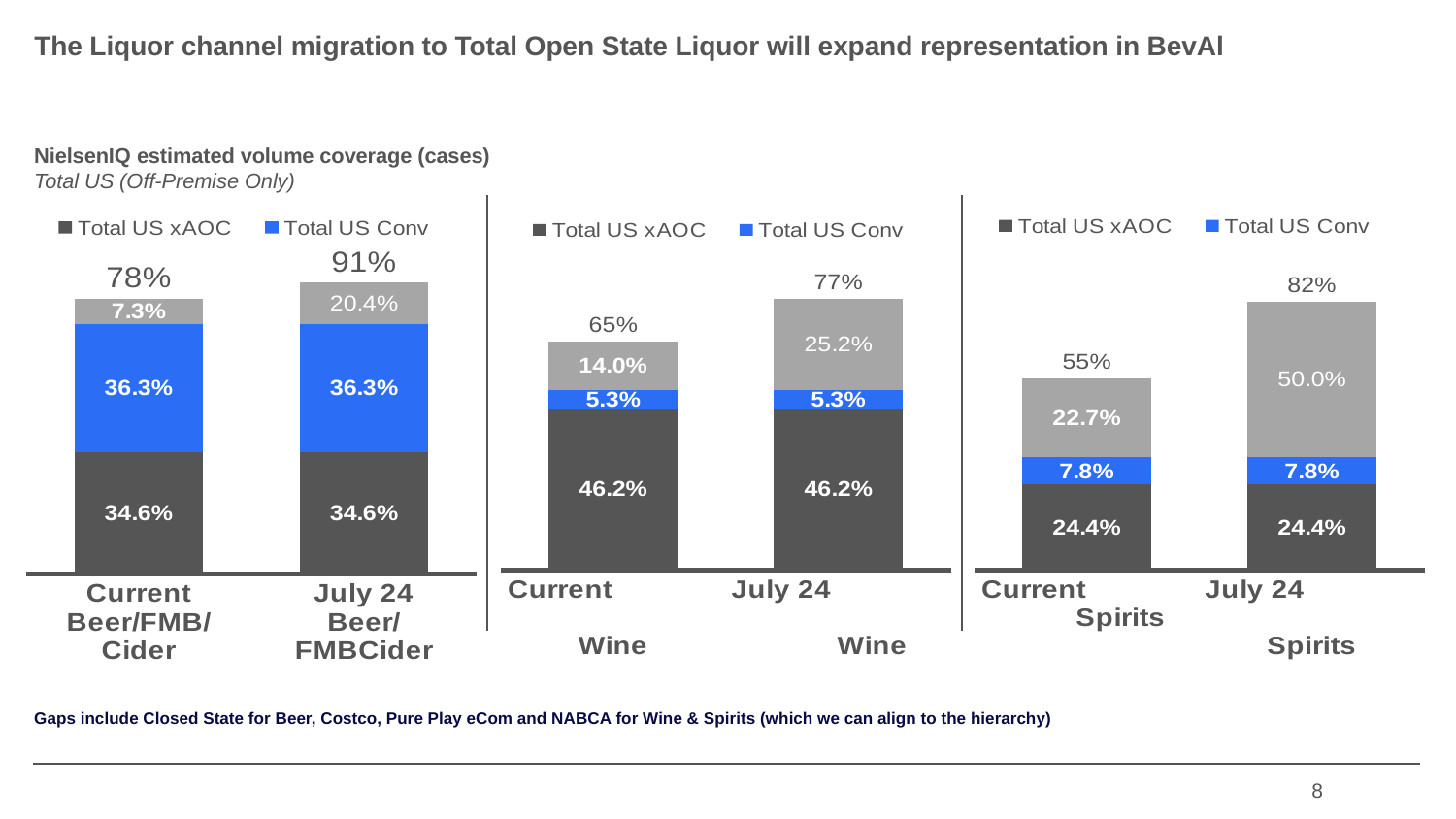
In the middle chart (Wine), what total is printed above the Current bar? 65% In the right chart (Spirits), what is the difference between the totals printed above the July 24 and Current bars? 27 percentage points How many series does the legend of the middle chart (Wine) list? 2 In the left chart (Beer/FMB/Cider), what is the Total US xAOC value for the Current bar? 34.6% In the left chart (Beer/FMB/Cider), which bar has the higher printed total, Current or July 24? July 24 What kind of chart is used on this slide? Stacked bar chart In the right chart (Spirits), what is the value of the top light grey segment of the July 24 bar? 50.0% In the middle chart (Wine), what is the Total US xAOC value for the Current bar? 46.2% In the middle chart (Wine), what is the value of the top light grey segment of the July 24 bar? 25.2% In the left chart (Beer/FMB/Cider), what total is printed above the July 24 bar? 91% In the right chart (Spirits), what is the Total US Conv value for the Current bar? 7.8% In the left chart (Beer/FMB/Cider), what is the Total US Conv value for the July 24 bar? 36.3%